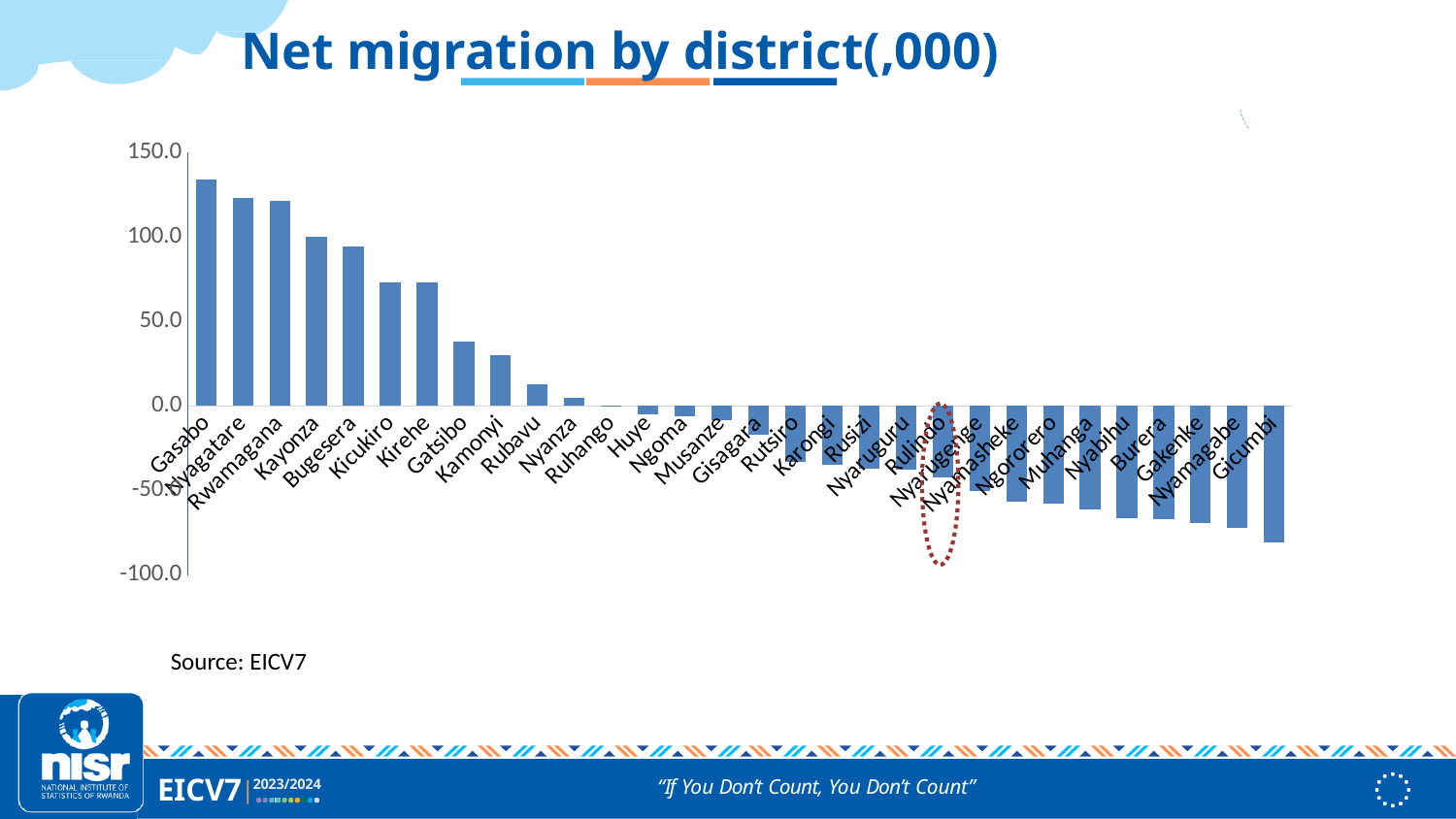
How many districts are plotted in the chart? 30 Is the value for Kicukiro greater or less than 50.0? greater What kind of chart is shown on the slide? Bar chart Is the value for Gasabo greater or less than 100.0? greater Which district has the lowest net migration? Gicumbi Do the values rise or fall moving from left to right along the x axis? Fall Which district has the highest net migration? Gasabo Is the value for Bugesera greater or less than 100.0? less Which has the larger net migration, Gasabo or Nyagatare? Gasabo